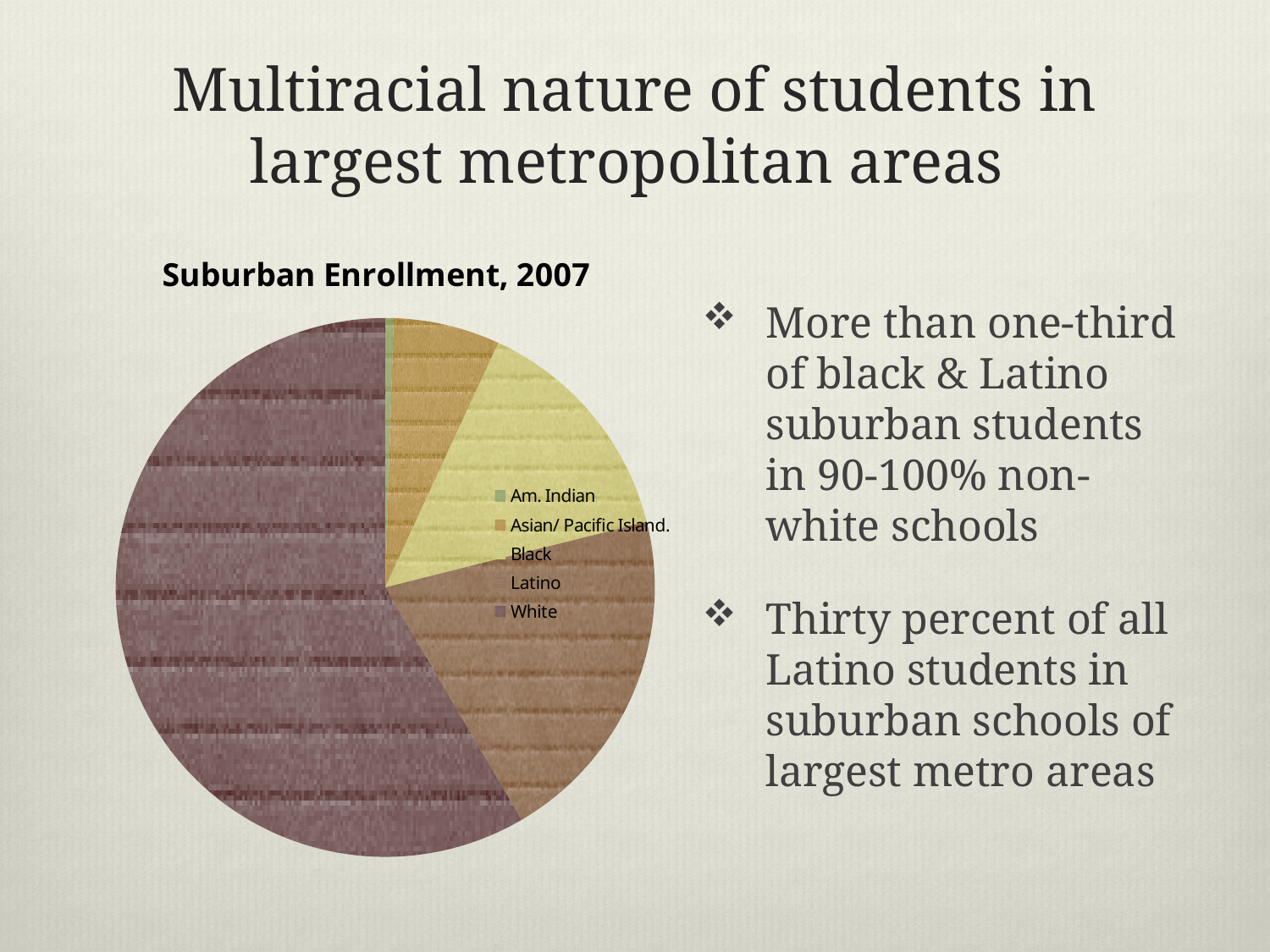
Does the White slice take up more or less than half of the pie? more Which slice is larger, Black or Asian/ Pacific Island.? Black Which slice is larger, Latino or Black? Latino Which category has the largest slice of the pie? White How many categories does the pie chart show? 5 What is the title of the chart? Suburban Enrollment, 2007 Which category has the smallest slice of the pie? Am. Indian Which category is listed first in the legend? Am. Indian What kind of chart is shown on the slide? pie chart